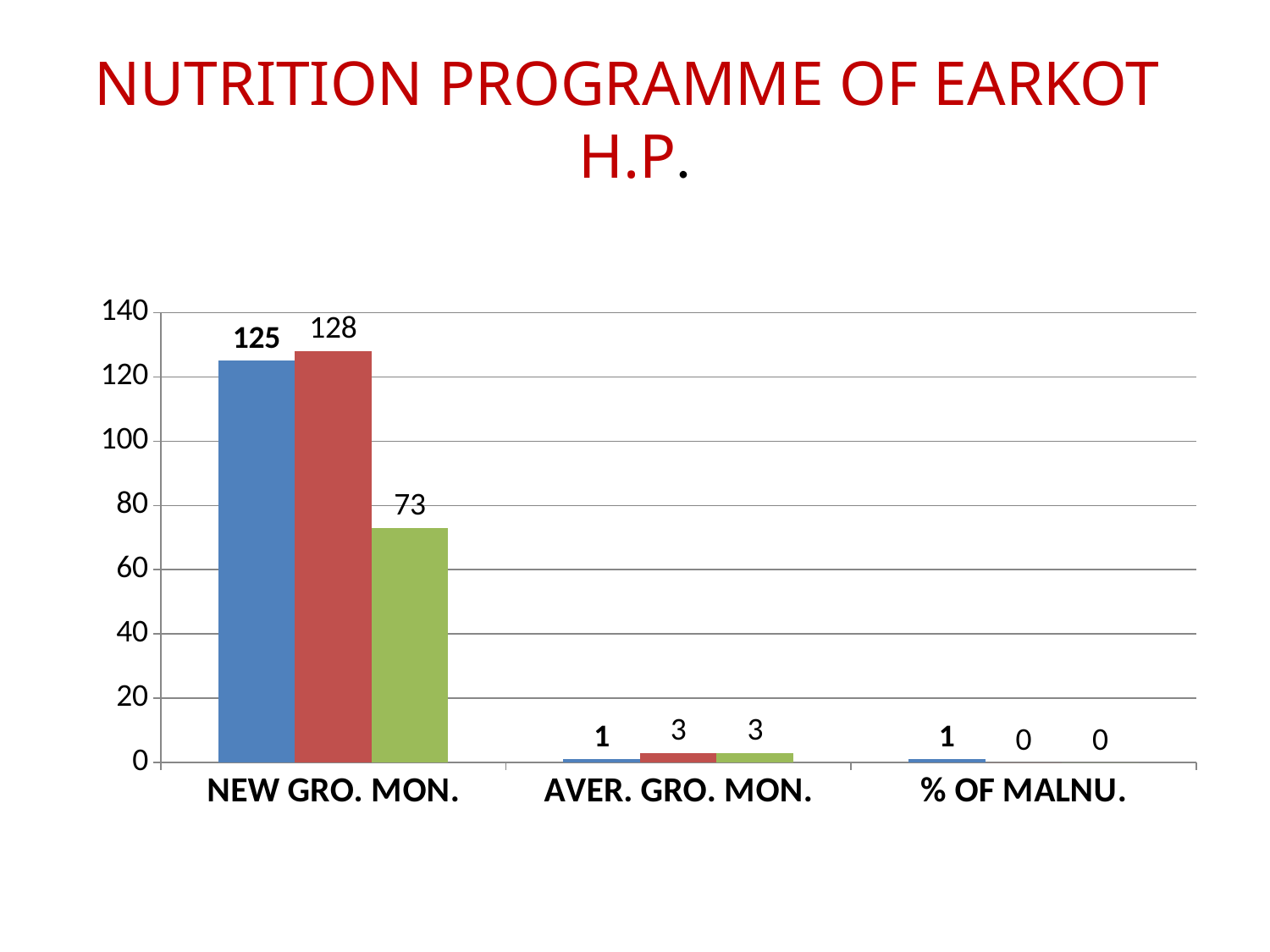
What is the title of the slide containing the chart? NUTRITION PROGRAMME OF EARKOT H.P. What kind of chart is shown on the slide? bar chart Which category has the highest value for the red bars? NEW GRO. MON. What is the value of the red bar for % OF MALNU.? 0 What is the value of the red bar for NEW GRO. MON.? 128 Which is larger for NEW GRO. MON., the blue bar or the green bar? the blue bar Is the value of the green bar for NEW GRO. MON. greater or less than 80? less How many categories are shown on the x axis of the chart? 3 What is the value of the green bar for NEW GRO. MON.? 73 What is the value of the blue bar for NEW GRO. MON.? 125 What is the difference between the red bar and the green bar for NEW GRO. MON.? 55 What is the value of the blue bar for AVER. GRO. MON.? 1